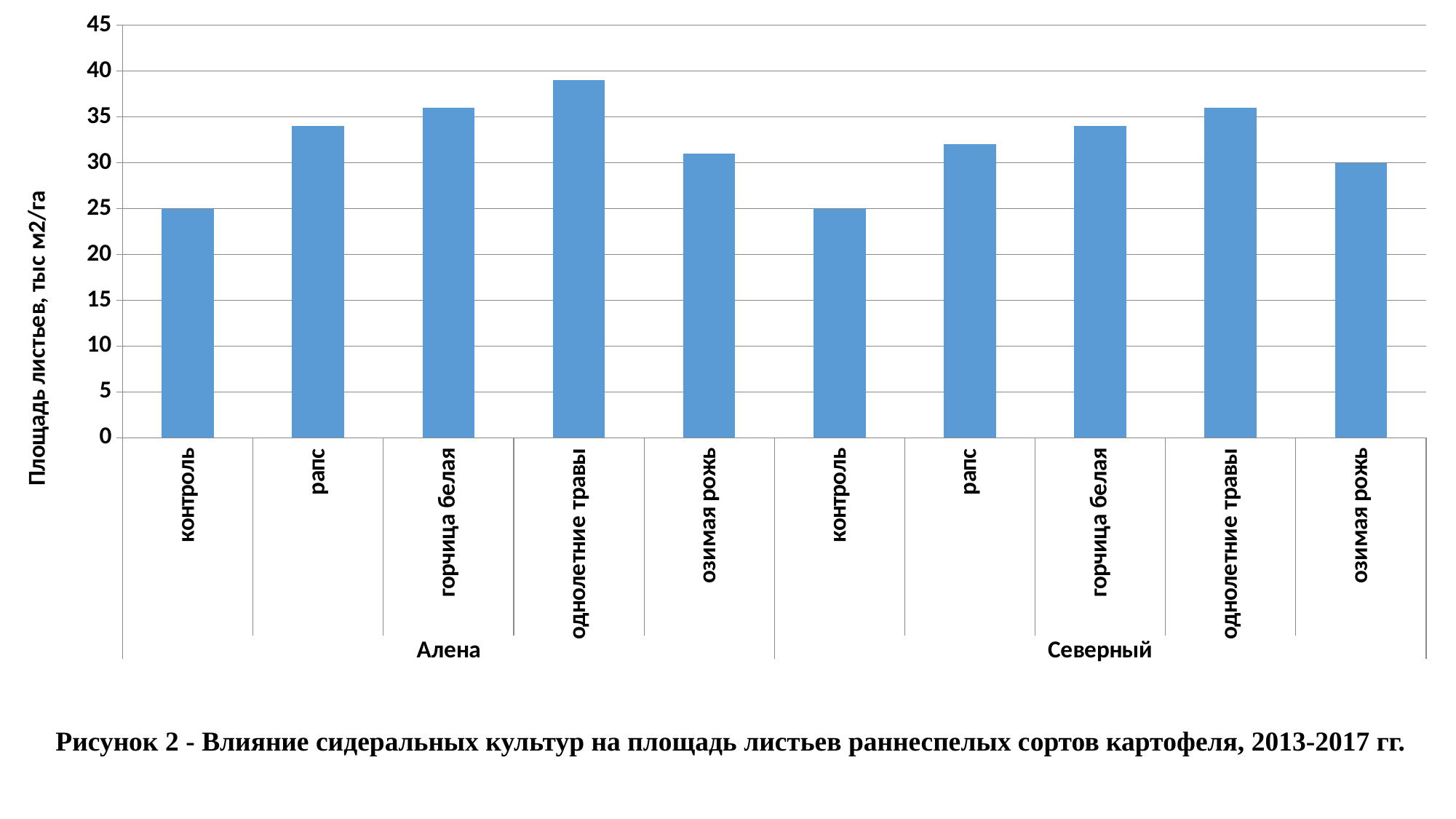
Is the value for горчица белая in the Северный group greater or less than 35? less How many bars are plotted on the chart? 10 Is the value for однолетние травы in the Алена group greater or less than 35? greater What is the value for озимая рожь in the Северный group? 30 Which bar has the highest value on the chart? однолетние травы (Алена) Which is larger: однолетние травы for Алена or однолетние травы for Северный? однолетние травы for Алена What type of chart is shown on the slide? bar chart What is the value for контроль in the Северный group? 25 Is the value for рапс in the Северный group greater or less than 30? greater What is the label of the vertical axis? Площадь листьев, тыс м2/га What is the value for контроль in the Алена group? 25 Which category has the lowest value within the Алена group? контроль